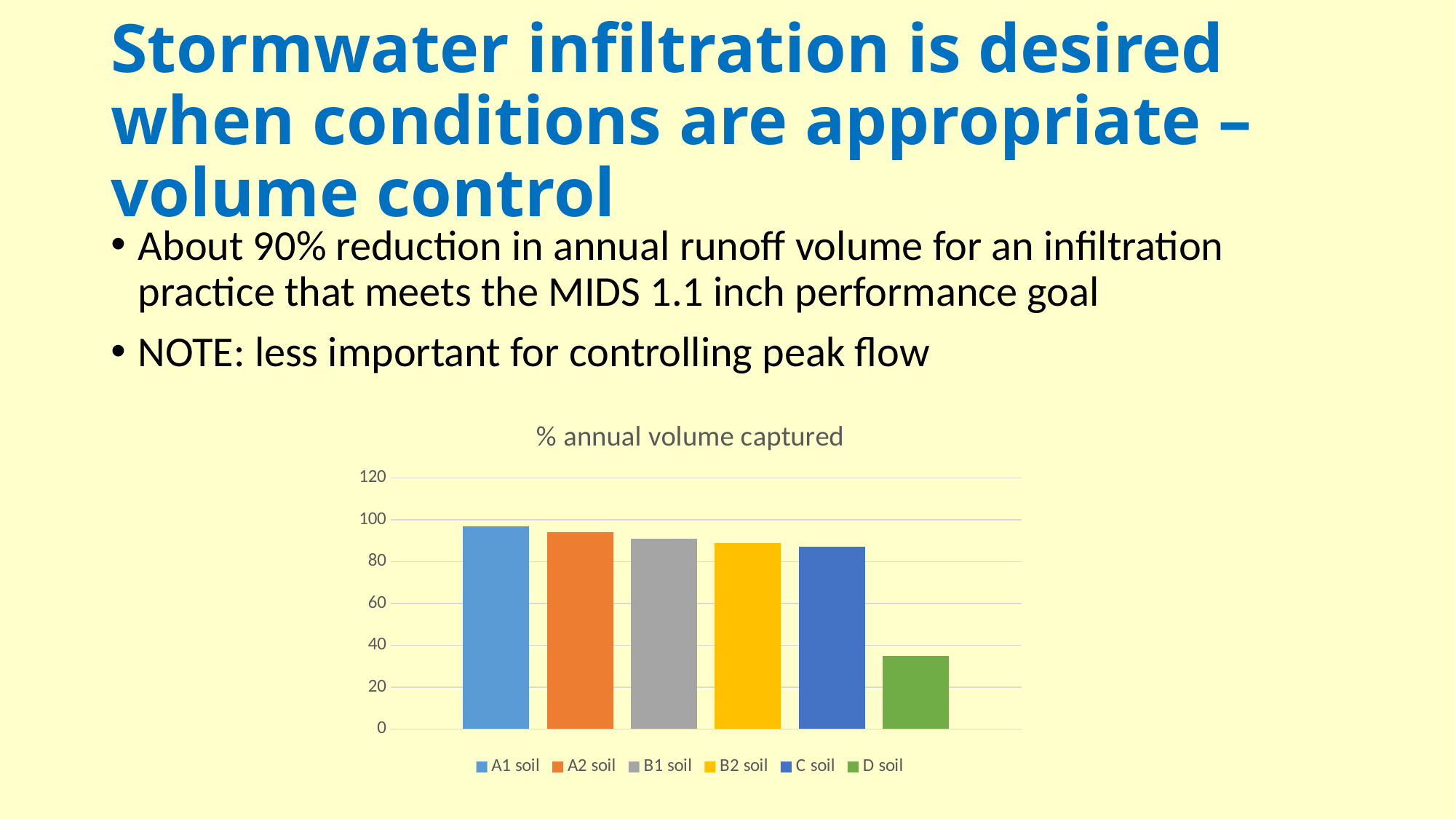
Which soil type has the lowest % annual volume captured? D soil How many bars are plotted in the chart? 6 What kind of chart is shown on the slide? bar chart Is the value for C soil greater or less than 100? less Which is larger, the value for A1 soil or the value for C soil? A1 soil Do the bar values rise or fall from left to right across the chart? fall Which soil type has the highest % annual volume captured? A1 soil What is the title of the chart? % annual volume captured Is the value for A1 soil greater or less than 80? greater How many entries does the chart legend list? 6 Which is larger, the value for C soil or the value for D soil? C soil Is the value for D soil greater or less than 40? less